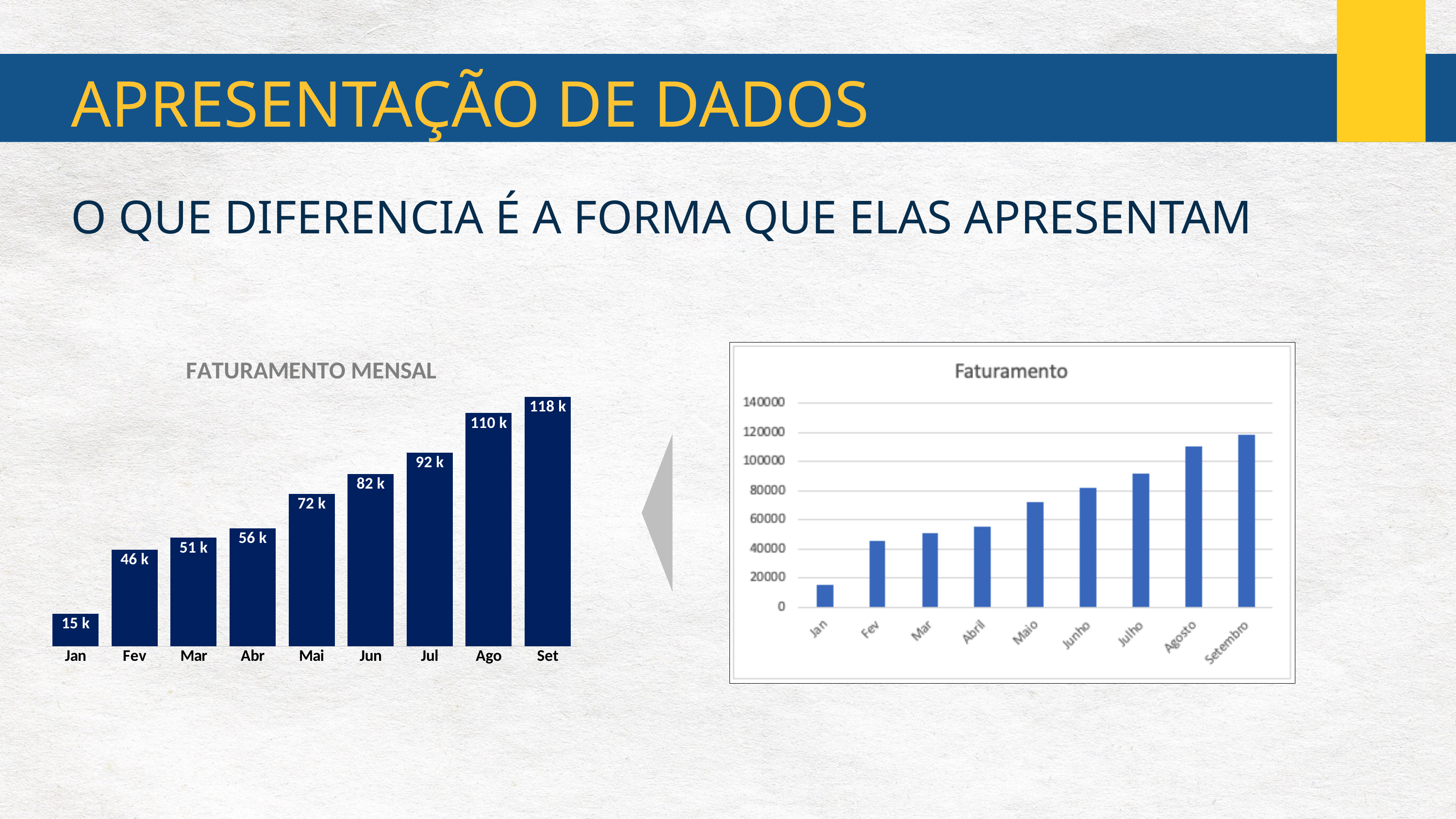
In the FATURAMENTO MENSAL chart, what is the value for Set? 118 k What kind of chart is the Faturamento chart on the right? bar chart In the Faturamento chart on the right, is the value for Setembro greater or less than 100000? greater In the FATURAMENTO MENSAL chart, what is the value for Mai? 72 k In the FATURAMENTO MENSAL chart, which is larger, the value for Abr or the value for Fev? Abr In the FATURAMENTO MENSAL chart, how many months are plotted? 9 In the FATURAMENTO MENSAL chart, what is the difference between the values for Set and Jan? 103 k In the FATURAMENTO MENSAL chart, what is the difference between the values for Ago and Jul? 18 k In the FATURAMENTO MENSAL chart, which month has the highest value? Set In the FATURAMENTO MENSAL chart, which month has the lowest value? Jan In the Faturamento chart on the right, is the value for Jan greater or less than 20000? less In the FATURAMENTO MENSAL chart, do the values rise or fall from Jan to Set? rise